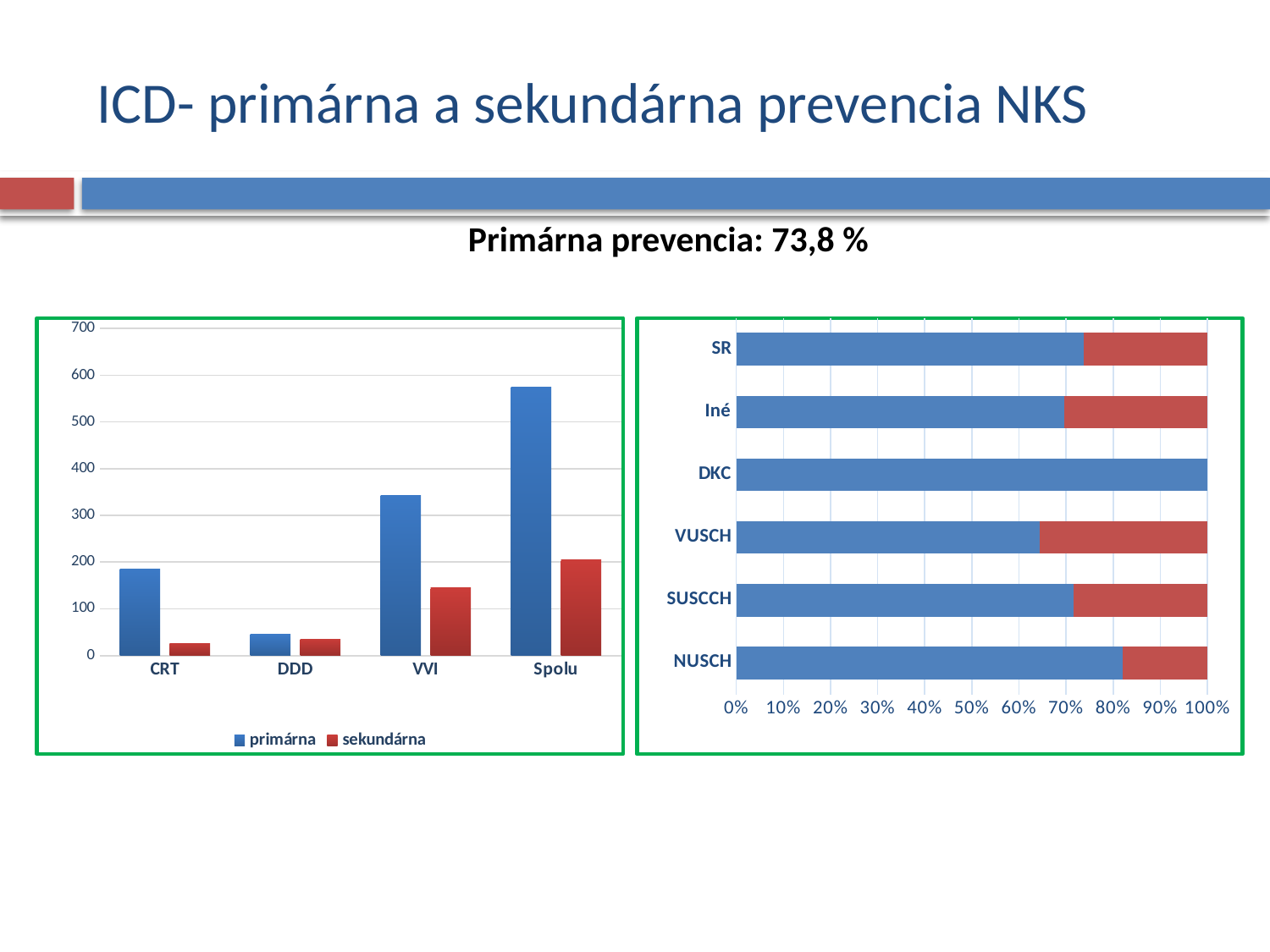
How many series does the legend of the left chart list? 2 In the left chart, is the sekundárna value for VVI greater or less than 100? greater In the left chart, which is larger for VVI: the primárna value or the sekundárna value? primárna In the right chart, is the blue share for VUSCH greater or less than 70%? less In the left chart, which category has the highest primárna value? Spolu In the left chart, which category has the lowest primárna value? DDD How many categories are shown on the vertical axis of the right chart? 6 In the left chart, is the primárna value for Spolu greater or less than 500? greater How many categories are shown on the x axis of the left chart? 4 What kind of chart is the left chart on the slide? bar chart In the right chart, which category has the largest blue share? DKC